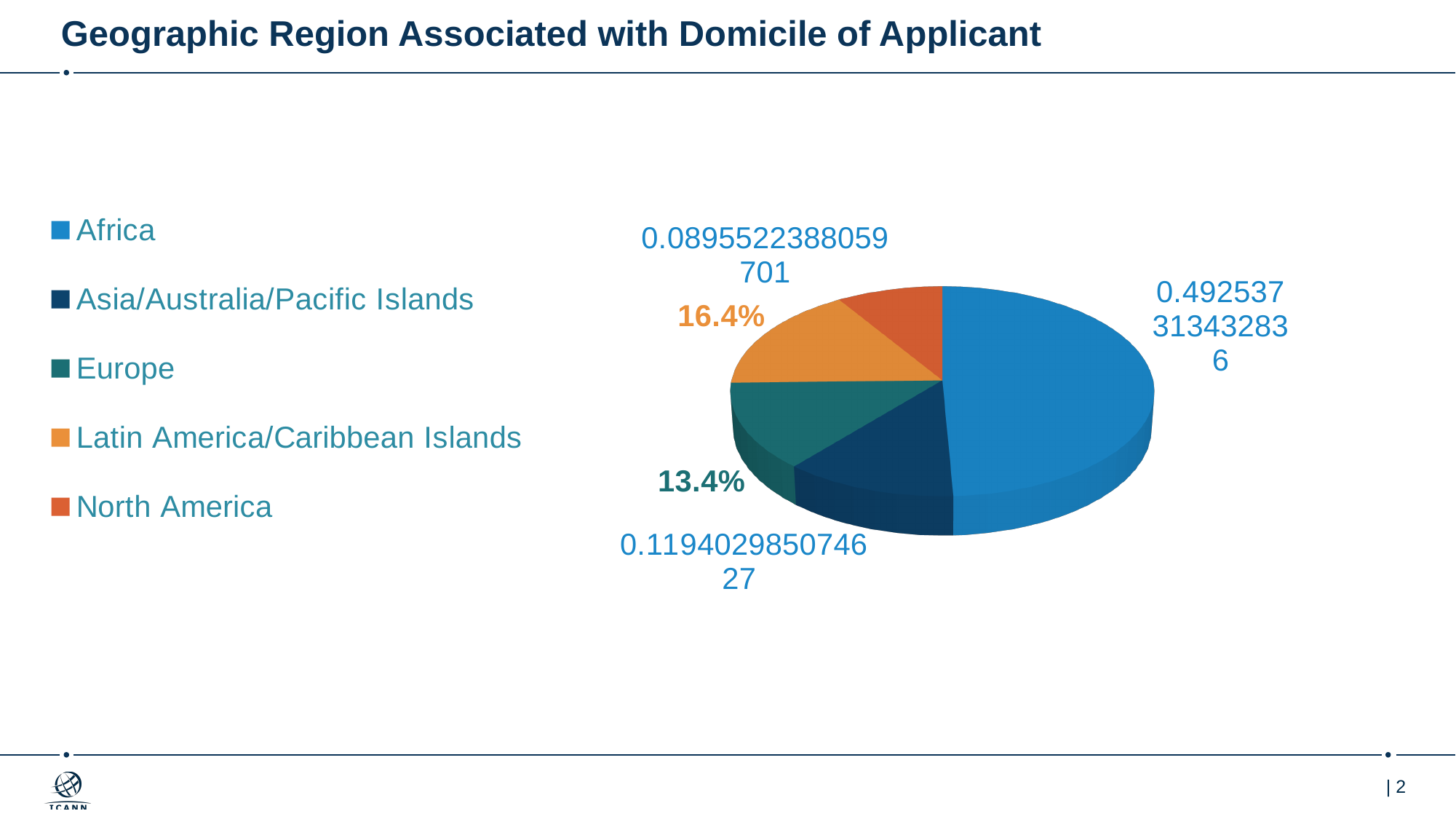
Which region has the smallest slice of the pie? North America What kind of chart is shown on the slide? pie chart What percentage is labelled on the Latin America/Caribbean Islands slice? 16.4% Which slice is larger, Latin America/Caribbean Islands or Europe? Latin America/Caribbean Islands What is the title of the chart? Geographic Region Associated with Domicile of Applicant What percentage is labelled on the Europe slice? 13.4% How many regions (slices) does the pie chart show? 5 What value is labelled on the North America slice? 0.0895522388059701 Which region has the largest slice of the pie? Africa By how many percentage points does the Latin America/Caribbean Islands slice exceed the Europe slice? 3.0% What value is labelled on the Asia/Australia/Pacific Islands slice? 0.119402985074627 What value is labelled on the Africa slice? 0.492537313432836